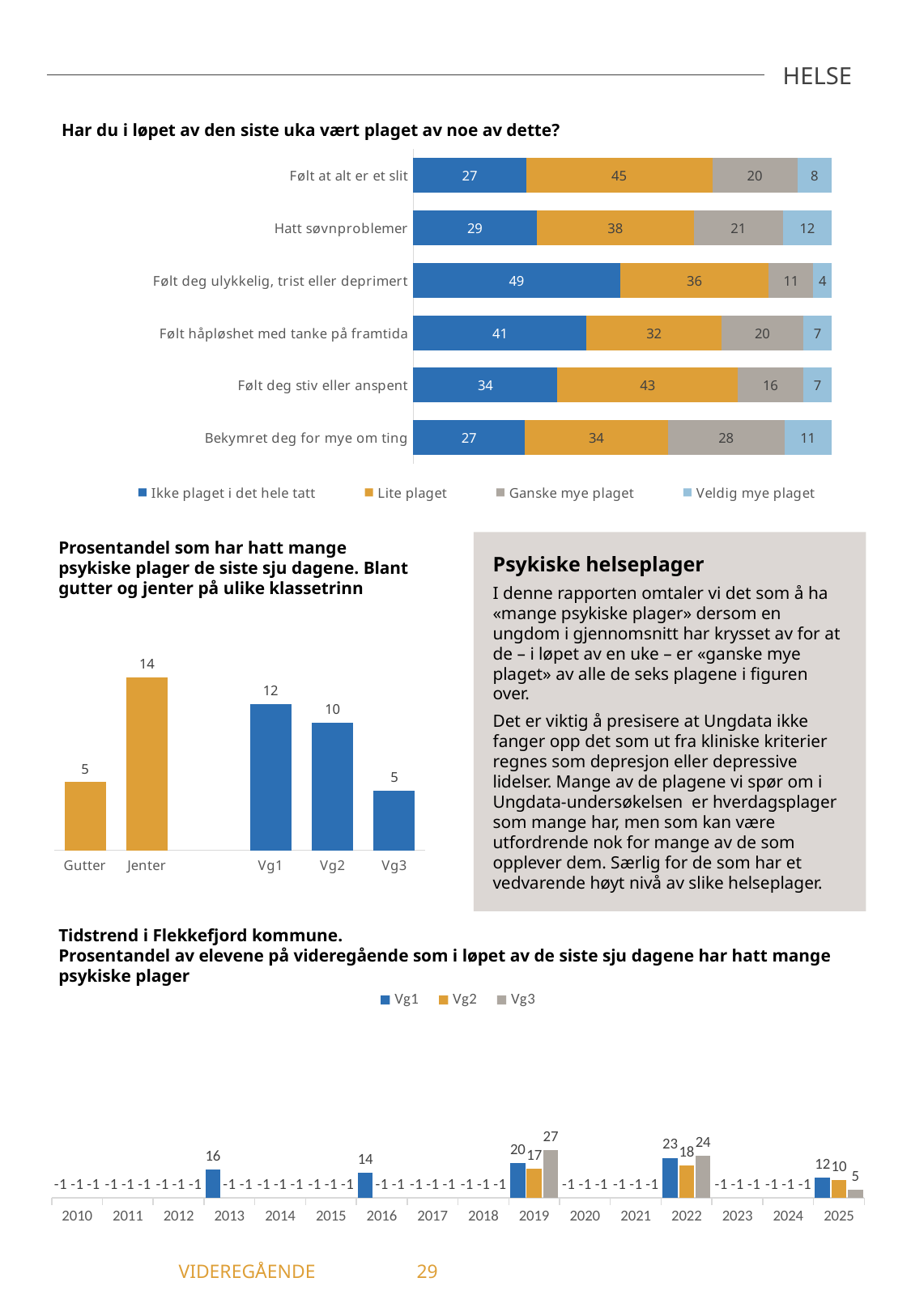
In the chart 'Tidstrend i Flekkefjord kommune', what is the difference between the Vg1 values for 2022 and 2025? 11 In the chart 'Tidstrend i Flekkefjord kommune', which year has the highest value for Vg1? 2022 In the chart 'Prosentandel som har hatt mange psykiske plager de siste sju dagene', which of Vg1 and Vg2 has the larger value? Vg1 In the chart 'Tidstrend i Flekkefjord kommune', what is the value for Vg3 in 2019? 27 In the chart 'Har du i løpet av den siste uka vært plaget av noe av dette?', what kind of chart is it? Stacked bar chart In the chart 'Prosentandel som har hatt mange psykiske plager de siste sju dagene', what is the value for Jenter? 14 In the chart 'Prosentandel som har hatt mange psykiske plager de siste sju dagene', how many categories are shown? 5 In the chart 'Har du i løpet av den siste uka vært plaget av noe av dette?', what is the difference between the 'Ganske mye plaget' values for 'Bekymret deg for mye om ting' and 'Følt deg ulykkelig, trist eller deprimert'? 17 In the chart 'Har du i løpet av den siste uka vært plaget av noe av dette?', how many series does the legend list? 4 In the chart 'Har du i løpet av den siste uka vært plaget av noe av dette?', which category has the highest value for 'Ikke plaget i det hele tatt'? Følt deg ulykkelig, trist eller deprimert In the chart 'Har du i løpet av den siste uka vært plaget av noe av dette?', what is the value for 'Lite plaget' in the 'Følt at alt er et slit' bar? 45 In the chart 'Prosentandel som har hatt mange psykiske plager de siste sju dagene', what is the difference between Jenter and Gutter? 9